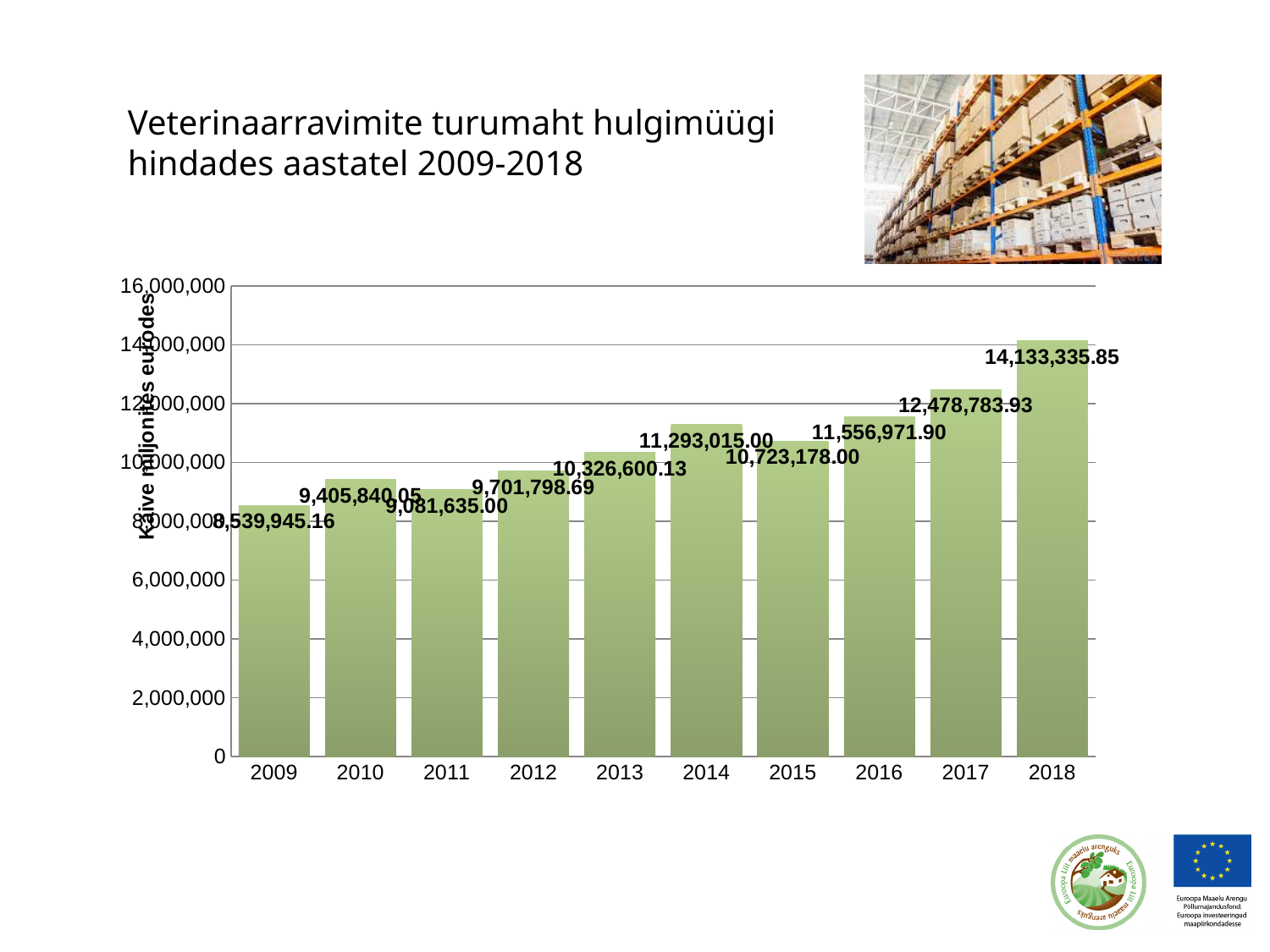
Which year has the lowest value? 2009 What is the value for 2009? 8,539,945.16 Which is larger, the value for 2010 or the value for 2011? 2010 What is the value for 2012? 9,701,798.69 What is the difference between the values for 2014 and 2015? 569,837.00 How many years are shown on the x axis? 10 What is the value for 2018? 14,133,335.85 Do the values generally rise or fall from 2009 to 2018? rise What is the difference between the values for 2018 and 2017? 1,654,551.92 Which year has the highest value? 2018 What kind of chart is shown on the slide? bar chart What is the value for 2015? 10,723,178.00